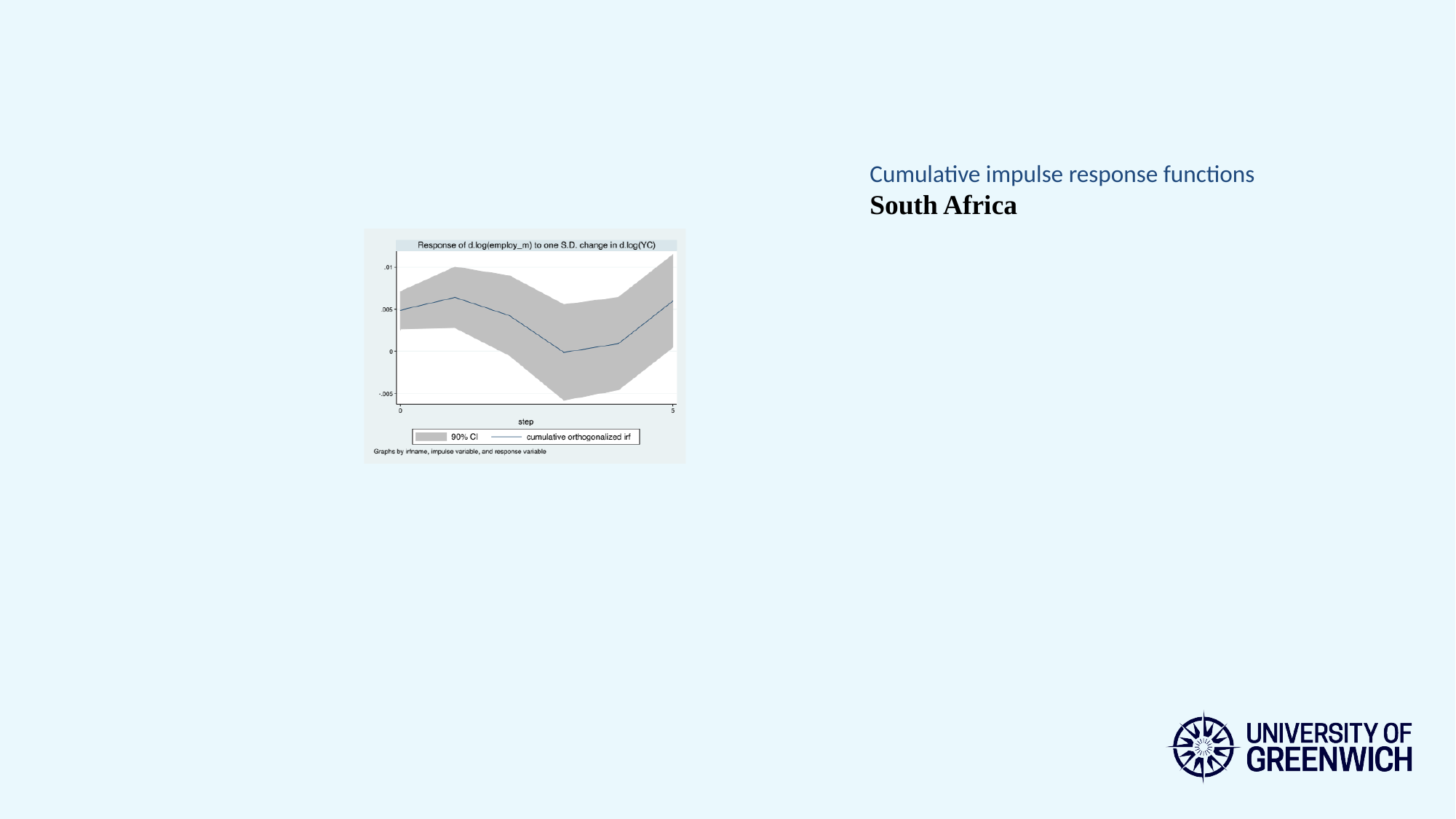
What is the title of the chart on the slide? Response of d.log(employ_m) to one S.D. change in d.log(YC) Is the value of the cumulative orthogonalized irf at step 3 greater or less than .005? less What kind of chart is shown on the slide? line chart At which step does the cumulative orthogonalized irf line reach its lowest value? 3 Is the lower edge of the 90% CI band at step 3 greater or less than 0? less Which is larger, the cumulative orthogonalized irf at step 1 or at step 3? step 1 Does the cumulative orthogonalized irf line rise or fall between step 3 and step 5? rise What is the label of the x axis of the chart? step How many entries does the chart's legend list? 2 Is the value of the cumulative orthogonalized irf at step 1 greater or less than .005? greater What confidence level does the shaded band in the chart represent, according to the legend? 90% CI Does the cumulative orthogonalized irf line rise or fall between step 1 and step 3? fall